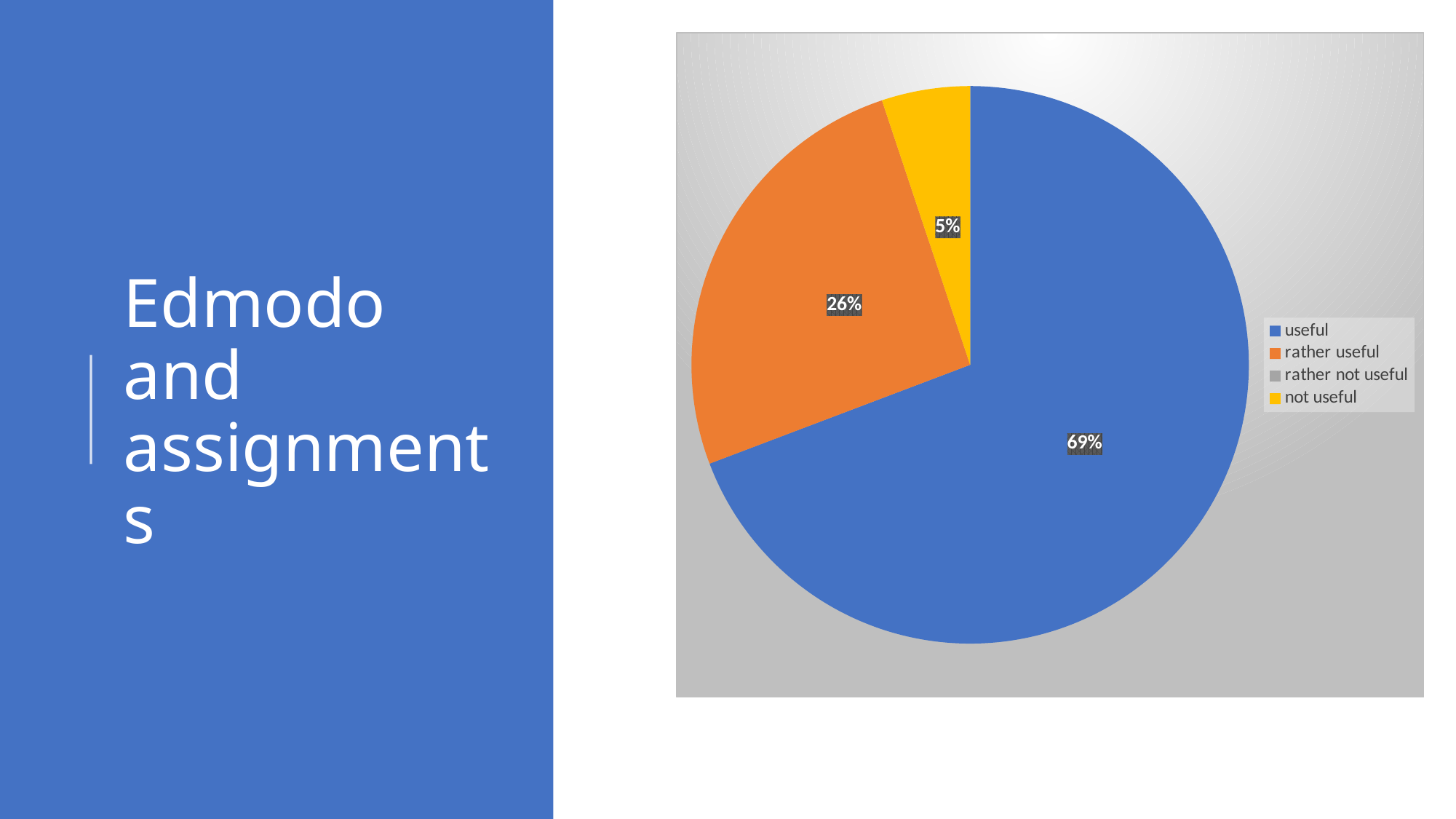
Which is larger, the "rather useful" slice or the "not useful" slice? rather useful What is the title text on the left of the slide? Edmodo and assignments Which labelled slice of the pie is the smallest? not useful What percentage is shown for the "rather useful" slice? 26% How many slices with data labels are visible in the pie? 3 What kind of chart is shown on the slide? pie chart What colour is the "rather useful" slice? orange What percentage is shown for the "not useful" slice? 5% What is the difference in percentage points between the "useful" and "rather useful" slices? 43 What percentage of the pie is labelled for the "useful" slice? 69% Which category has the largest slice of the pie? useful How many entries does the legend list? 4